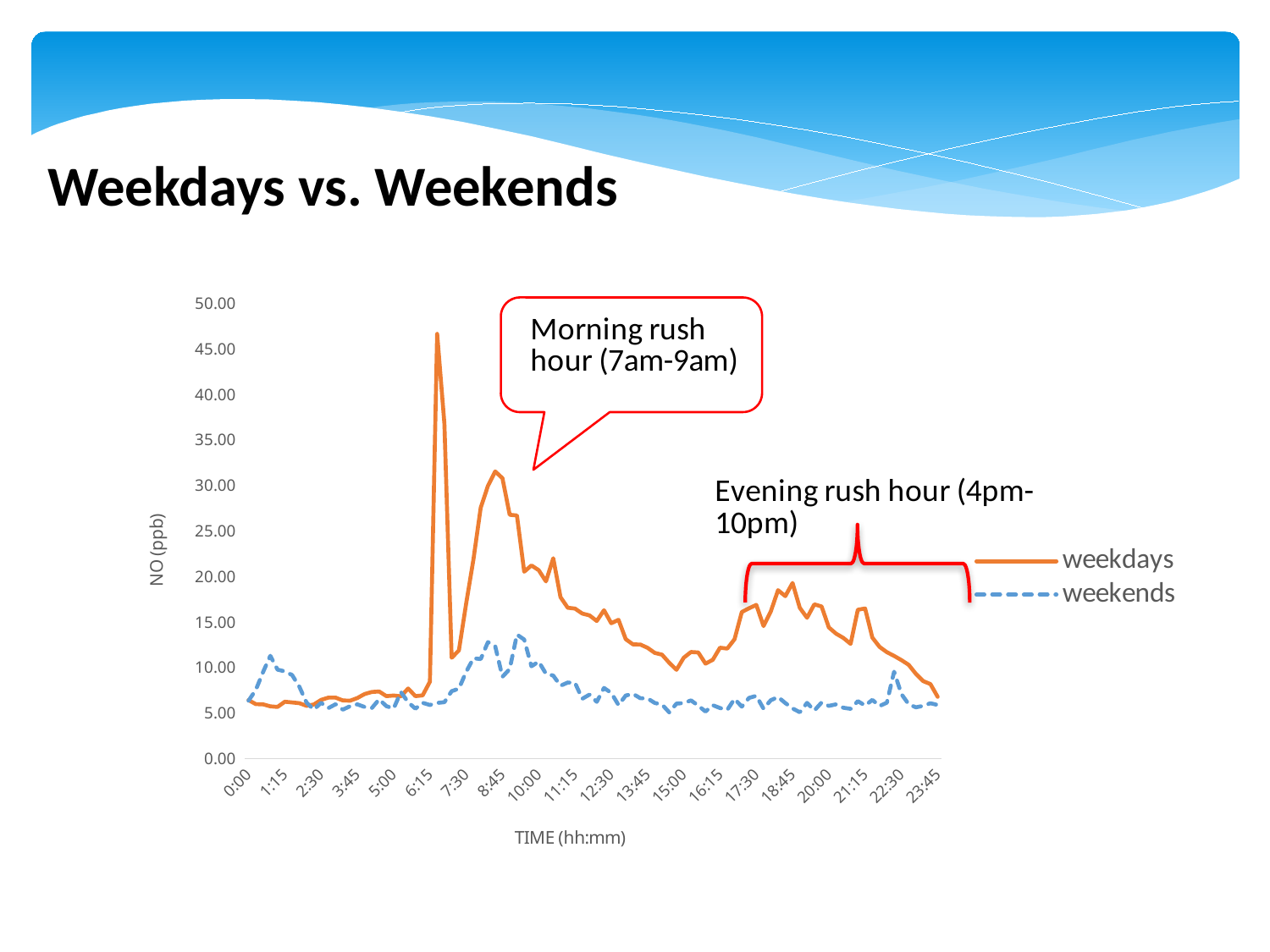
How many series does the legend list? 2 Does the weekdays series rise or fall between 8:45 and 15:00? fall Is the weekdays value at 8:45 greater or less than 25.00? greater What kind of chart is shown on the slide? line chart Is the highest value of the weekdays series greater or less than 40.00? greater At 8:45, which series has the larger value, weekdays or weekends? weekdays What is the label of the vertical axis? NO (ppb) Is the weekends value at 12:30 greater or less than 10.00? less Which series is drawn with a dashed line? weekends Which series reaches the highest value on the chart? weekdays